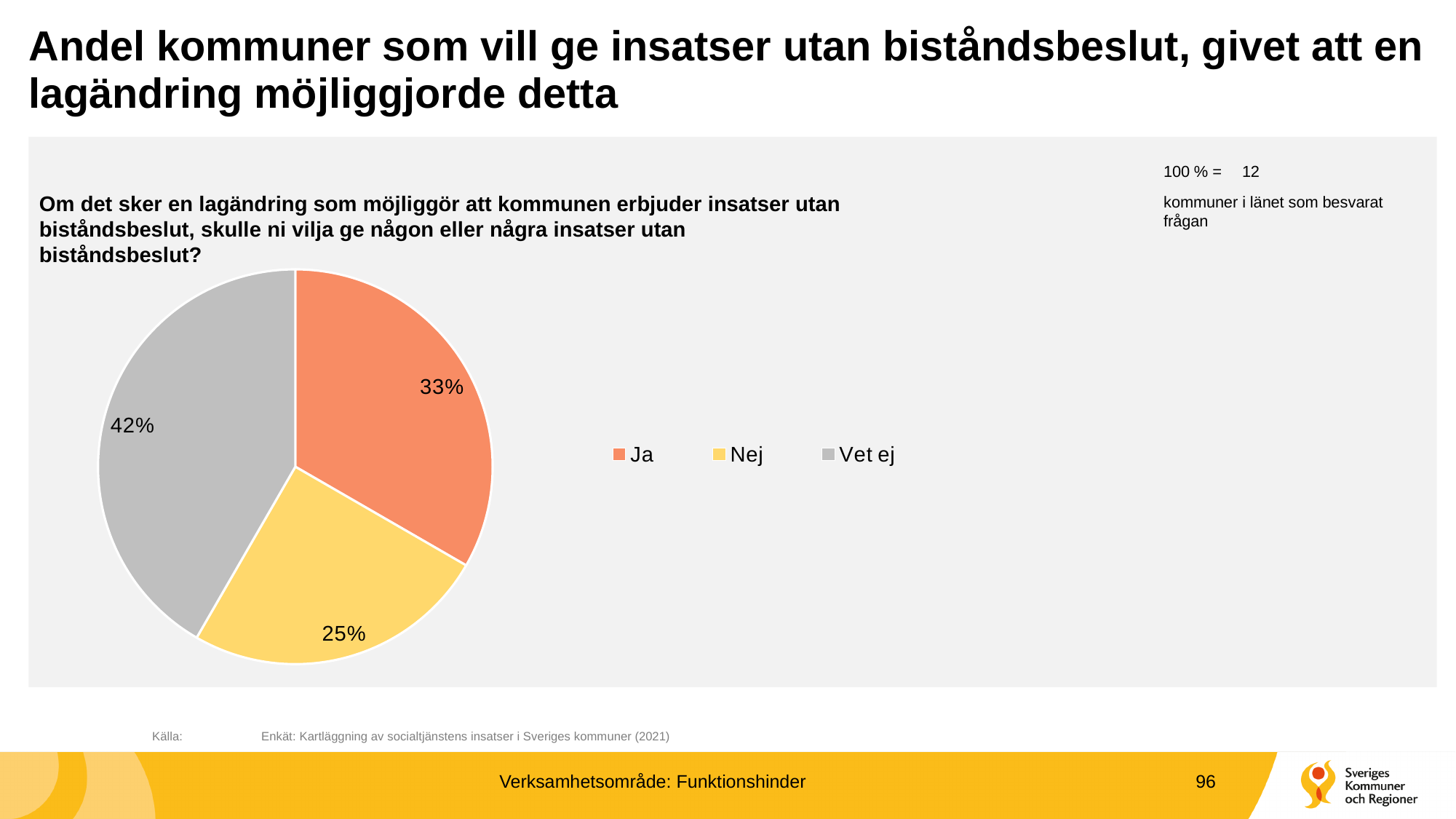
What percentage of the pie is labelled "Vet ej"? 42% How many slices does the pie chart have? 3 What kind of chart is shown on the slide? Pie chart What is the difference in percentage points between the "Ja" slice and the "Nej" slice? 8 What percentage of the pie is labelled "Ja"? 33% Which category has the smallest share of the pie? Nej Which slice is larger, "Ja" or "Nej"? Ja What colour is the "Vet ej" slice in the pie chart? Grey How many entries does the legend list? 3 Which category has the largest share of the pie? Vet ej What percentage of the pie is labelled "Nej"? 25% What is the difference in percentage points between the "Vet ej" slice and the "Ja" slice? 9